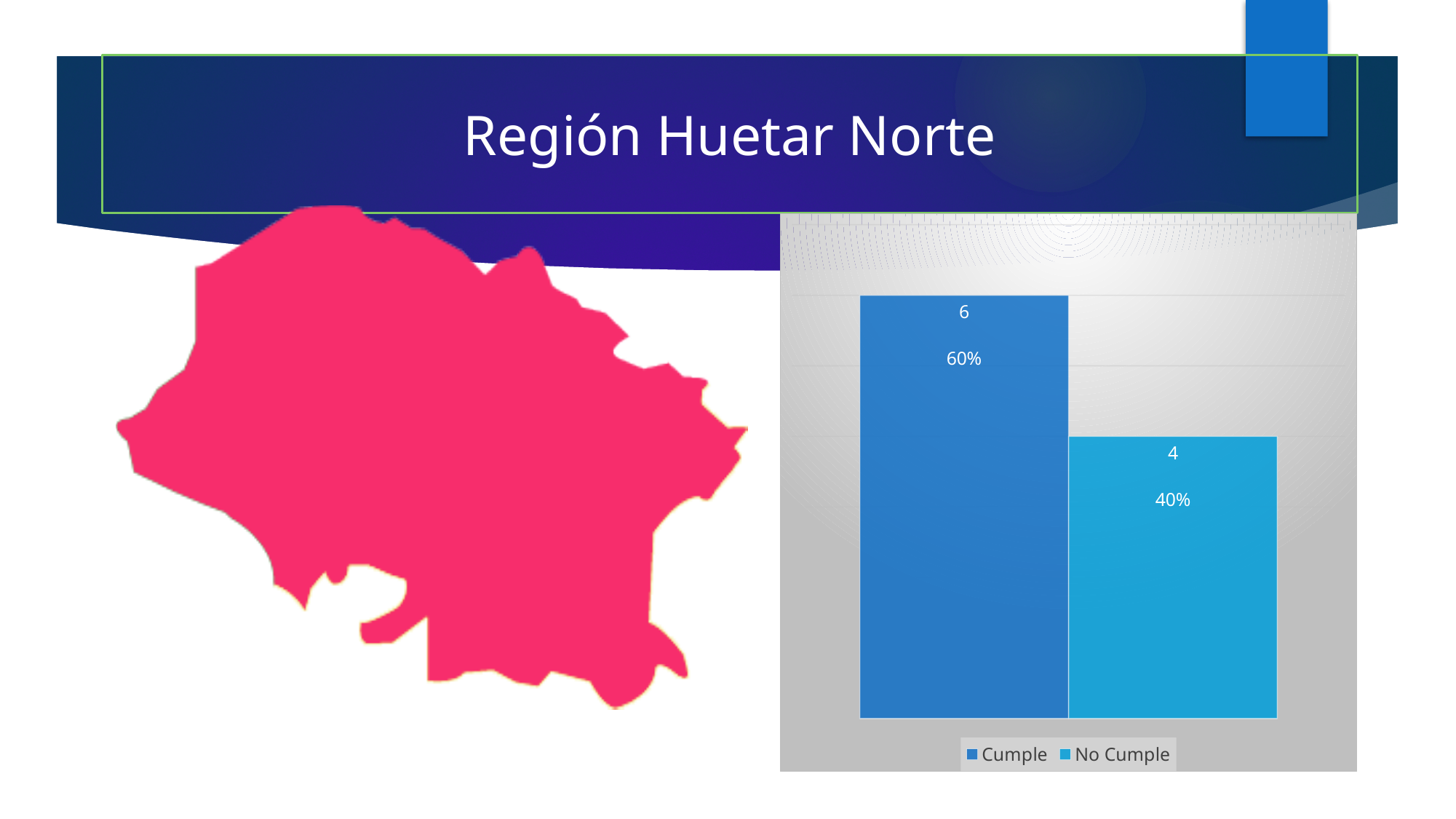
What is the total of the Cumple and No Cumple values? 10 What is the value for Cumple? 6 What is the value for No Cumple? 4 Which series has the highest value? Cumple What percentage is shown on the Cumple bar? 60% What is the title of the slide containing the chart? Región Huetar Norte What is the difference between the Cumple and No Cumple values? 2 How many series does the legend list? 2 Which series has the lowest value? No Cumple Which is larger, Cumple or No Cumple? Cumple What kind of chart is shown on the slide? Bar chart What percentage is shown on the No Cumple bar? 40%